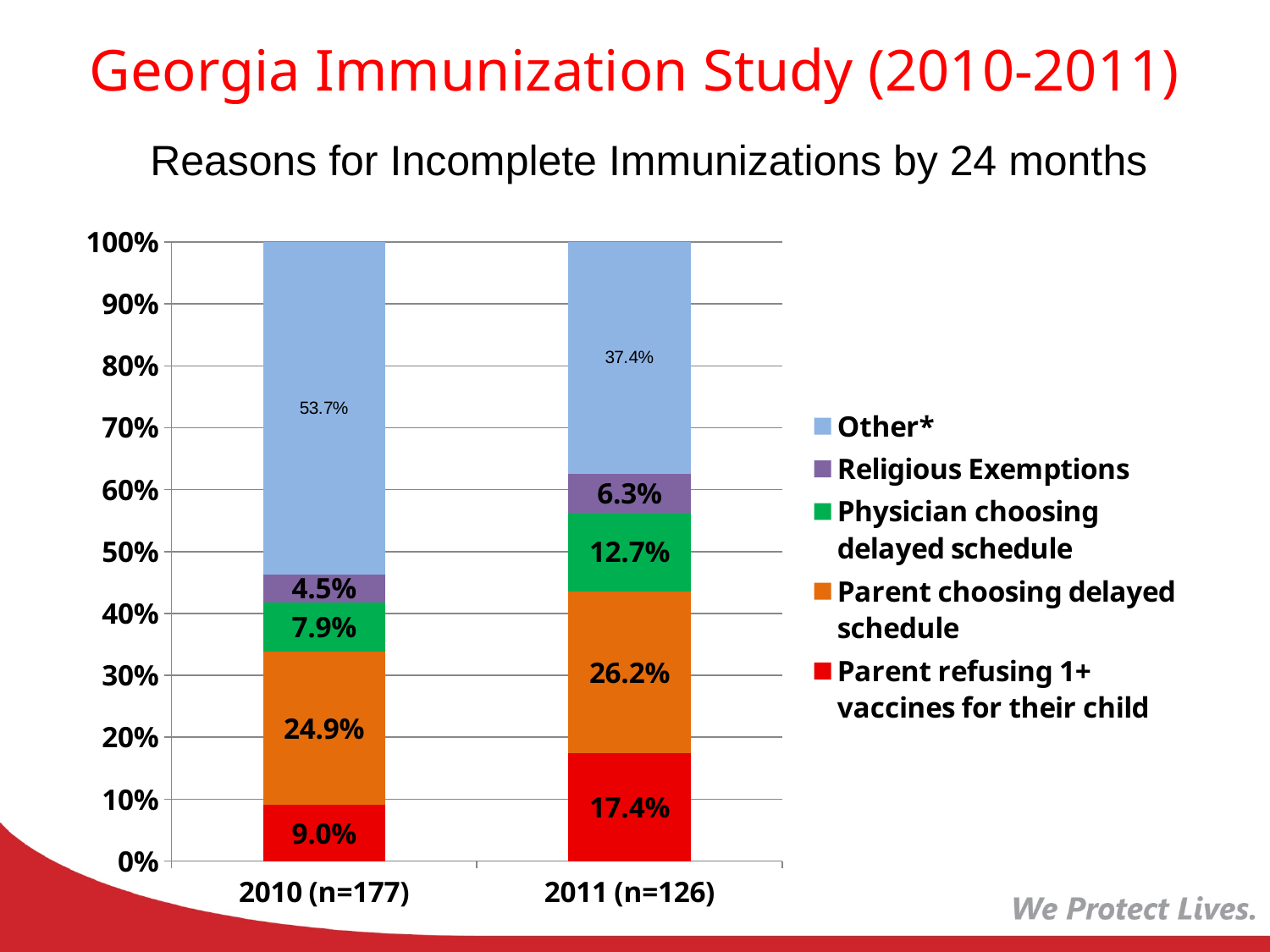
What share of the 2010 (n=177) bar is labelled Other*? 53.7% What is the value for Physician choosing delayed schedule in 2011 (n=126)? 12.7% Did the Other* share rise or fall from 2010 (n=177) to 2011 (n=126)? Fall How many series does the legend list? 5 What percentage of incomplete immunizations in 2010 (n=177) was due to parents refusing 1+ vaccines for their child? 9.0% By how many percentage points did the Parent refusing 1+ vaccines for their child share change from 2010 (n=177) to 2011 (n=126)? 8.4 percentage points Which reason has the smallest share in the 2010 (n=177) bar? Religious Exemptions What is the value for Religious Exemptions in 2011 (n=126)? 6.3% How many bars are shown on the chart? 2 What kind of chart is shown on the slide? Stacked bar chart Which year has the larger share for Parent choosing delayed schedule, 2010 (n=177) or 2011 (n=126)? 2011 (n=126) Which reason has the largest share in the 2011 (n=126) bar? Other*